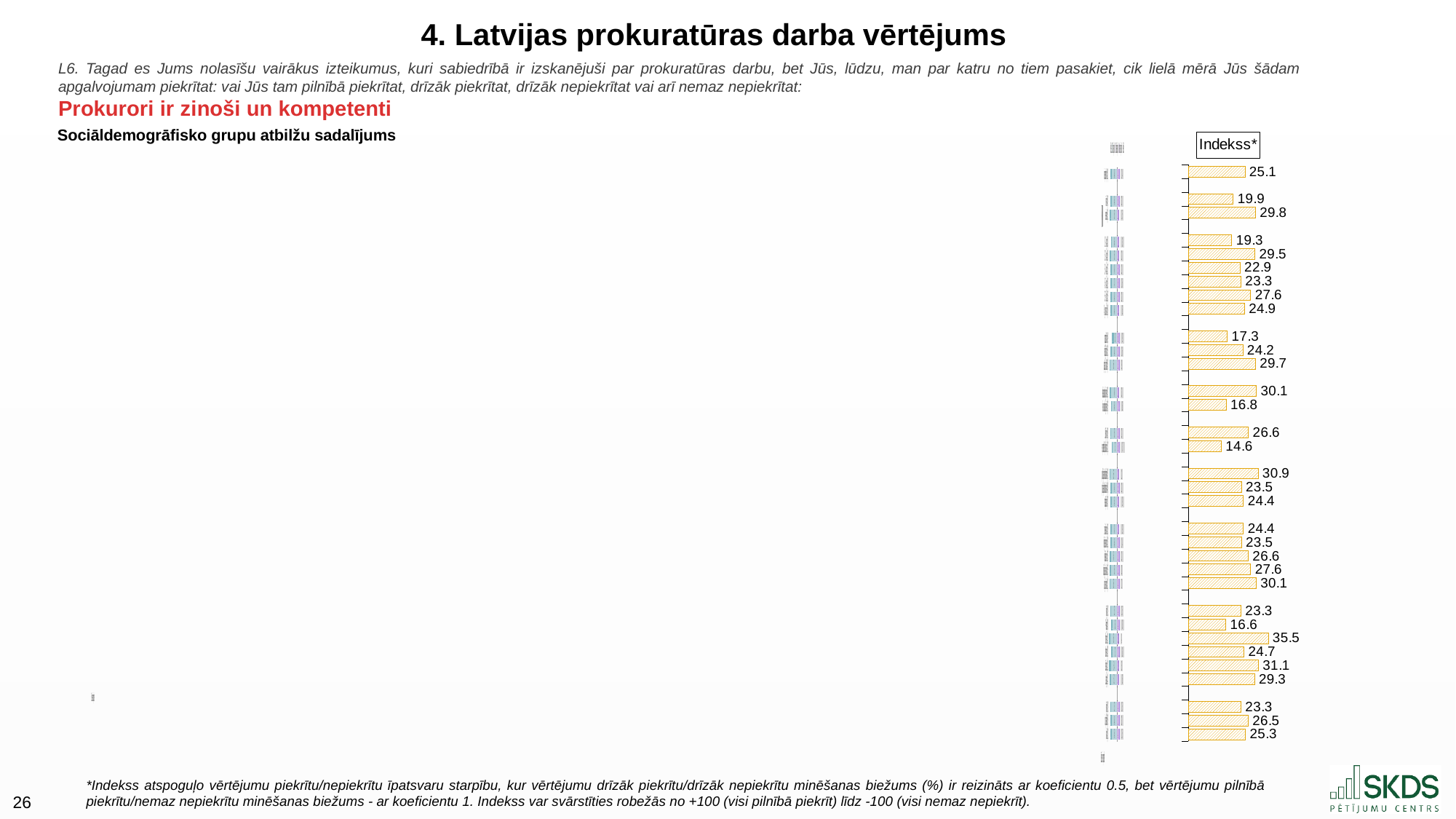
In the "Indekss*" chart, what is the lowest value shown? 14.6 What is the title shown above the chart on the right side of the slide? Indekss* In the "Indekss*" chart, what is the value of the second bar from the top? 19.9 In the "Indekss*" chart, which is larger: the topmost bar (25.1) or the second bar from the top (19.9)? the topmost bar (25.1) In the "Indekss*" chart, what is the difference between the highest value (35.5) and the lowest value (14.6)? 20.9 How many bars are plotted in the "Indekss*" chart? 33 In the "Indekss*" chart, what is the value of the bottommost bar? 25.3 In the "Indekss*" chart, what is the highest value shown? 35.5 In the "Indekss*" chart, what is the value of the topmost bar? 25.1 What kind of chart is the "Indekss*" chart on the right side of the slide? bar chart